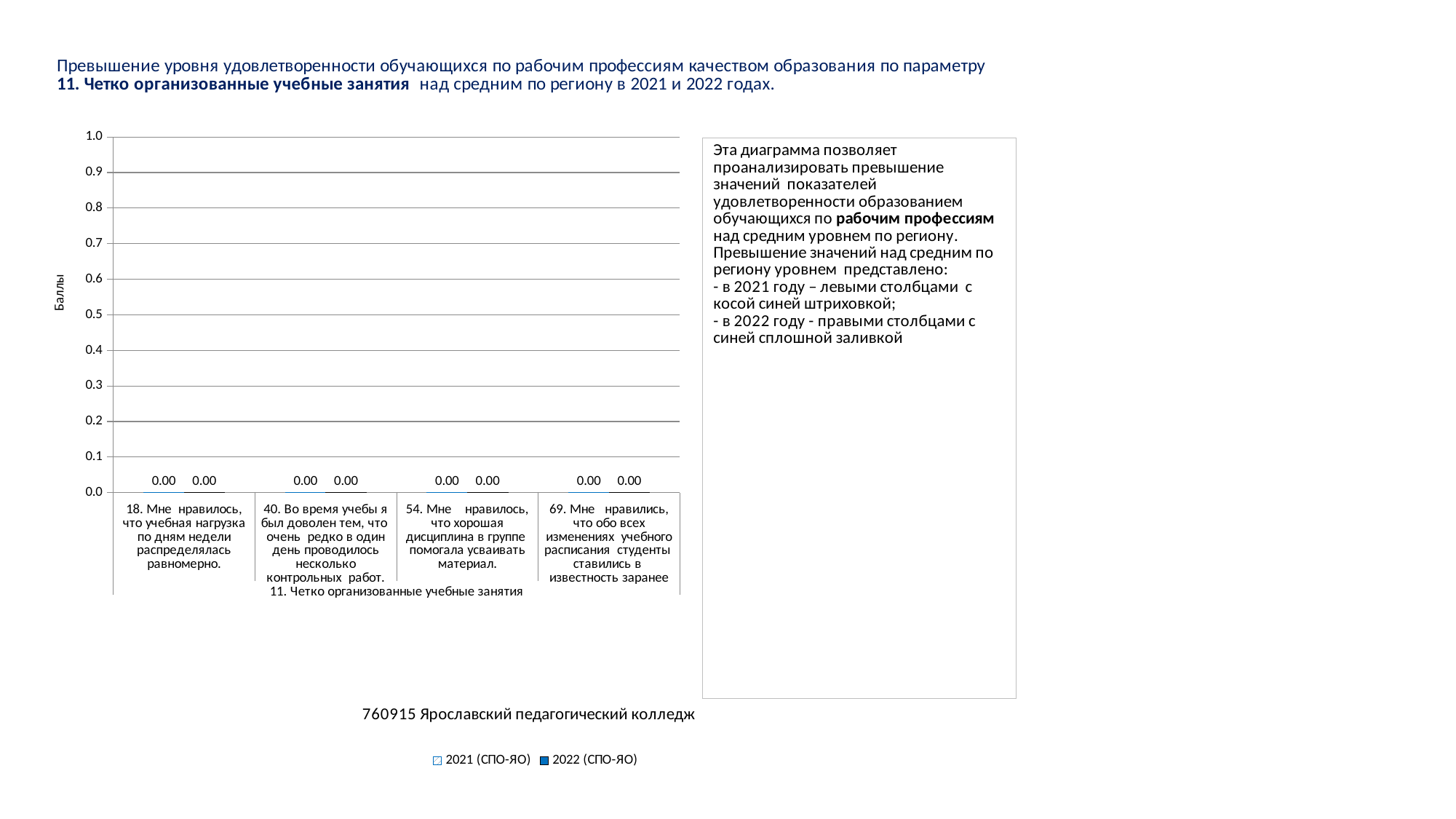
How many categories are shown on the x axis of the chart? 4 What is the value for 2021 (СПО-ЯО) for category 54 ("Мне нравилось, что хорошая дисциплина в группе помогала усваивать материал")? 0.00 What are the two series listed in the chart legend? 2021 (СПО-ЯО) and 2022 (СПО-ЯО) What is the value for 2022 (СПО-ЯО) for category 69 ("Мне нравились, что обо всех изменениях учебного расписания студенты ставились в известность заранее")? 0.00 Is the value for 2022 (СПО-ЯО) for category 54 greater or less than 0.1? less How many series does the chart legend list? 2 What is the difference between the 2021 (СПО-ЯО) and 2022 (СПО-ЯО) values for category 18? 0.00 What is the value for 2022 (СПО-ЯО) for category 40 ("Во время учебы я был доволен тем, что очень редко в один день проводилось несколько контрольных работ")? 0.00 What kind of chart is shown on the slide? Bar chart What is the label of the vertical axis of the chart? Баллы What is the value for 2021 (СПО-ЯО) for category 18 ("Мне нравилось, что учебная нагрузка по дням недели распределялась равномерно")? 0.00 What is the highest value shown on the vertical axis of the chart? 1.0